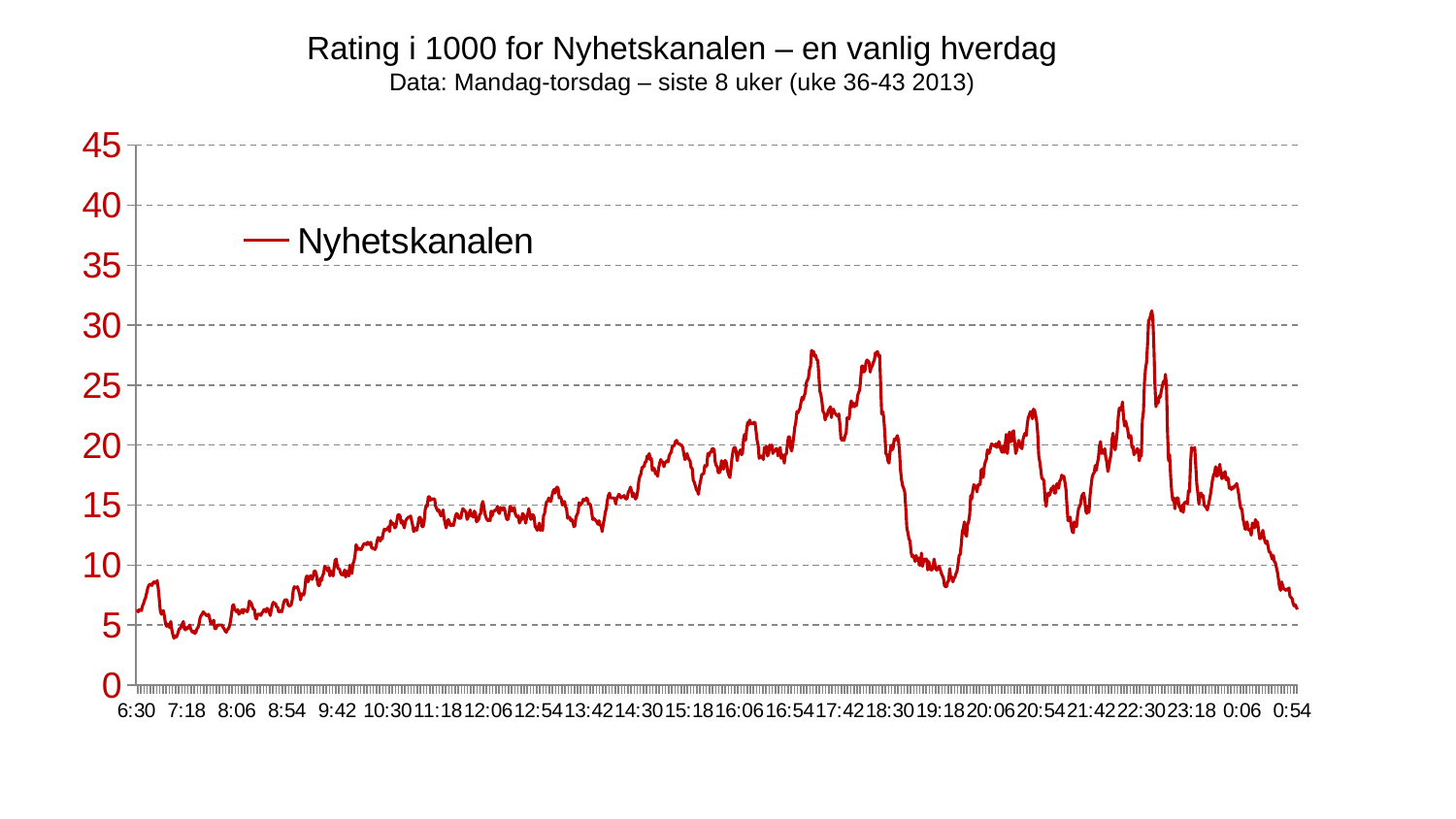
What is the title of the chart? Rating i 1000 for Nyhetskanalen – en vanlig hverdag Is the value for Nyhetskanalen at 12:06 greater or less than 20? less Is the value for Nyhetskanalen at 0:54 greater or less than 10? less Is the value for Nyhetskanalen at 14:30 greater or less than 15? greater Does the value for Nyhetskanalen rise or fall between 7:18 and 10:30? rise What kind of chart is shown on the slide? line chart What is the name of the series shown in the legend? Nyhetskanalen How many series does the legend list? 1 Does the value for Nyhetskanalen rise or fall between 23:18 and 0:54? fall